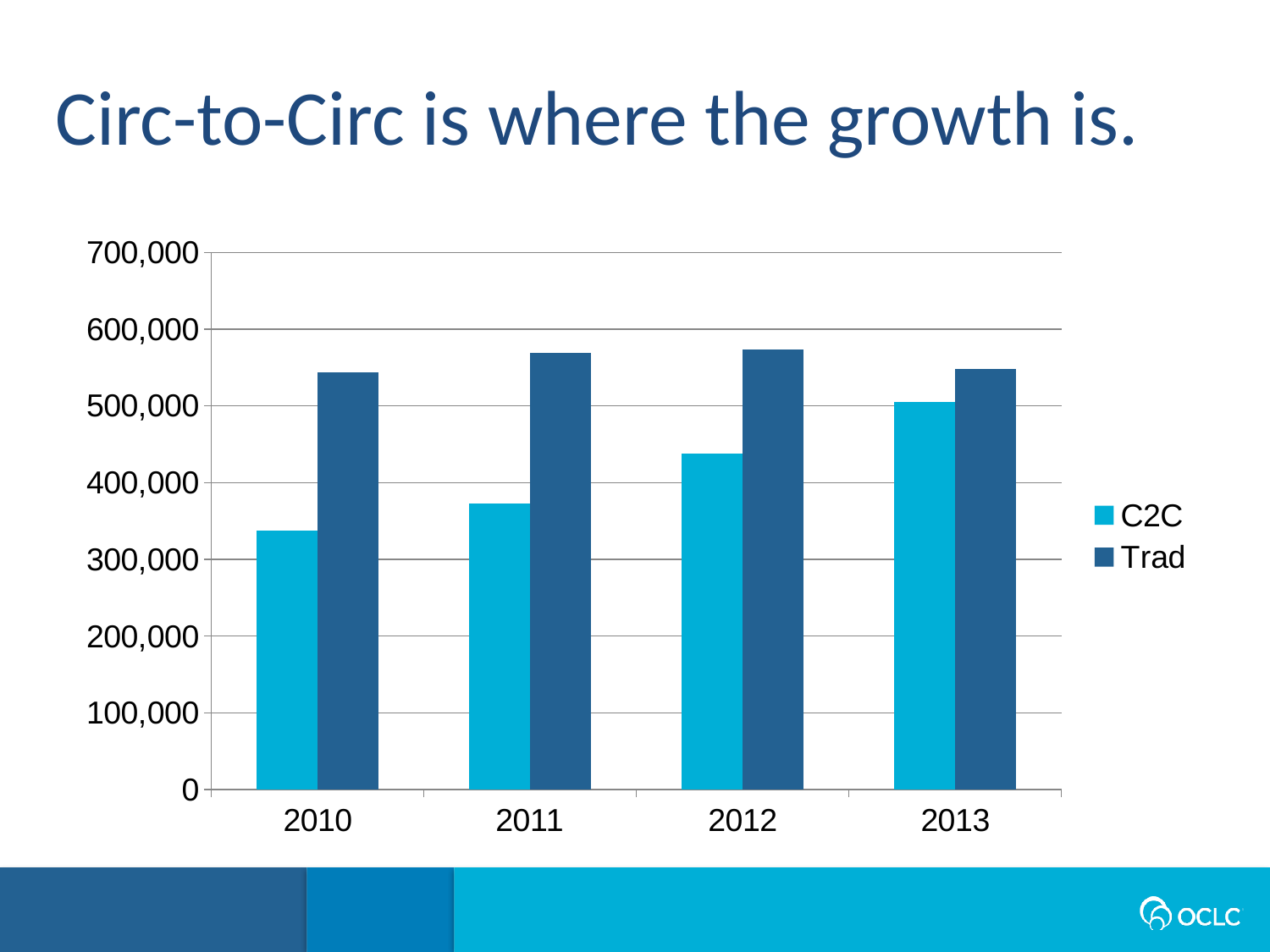
In 2010, which series has the larger value, C2C or Trad? Trad Is the Trad value for 2011 greater or less than 600,000? less How many series does the legend list? 2 In which year is the C2C value highest? 2013 Is the C2C value for 2010 greater or less than 400,000? less Is the Trad value for 2012 greater or less than 500,000? greater How many years are shown on the x axis? 4 Do the C2C values rise or fall from 2010 to 2013? rise What kind of chart is shown on the slide? bar chart In which year is the C2C value lowest? 2010 What is the title of the slide? Circ-to-Circ is where the growth is.